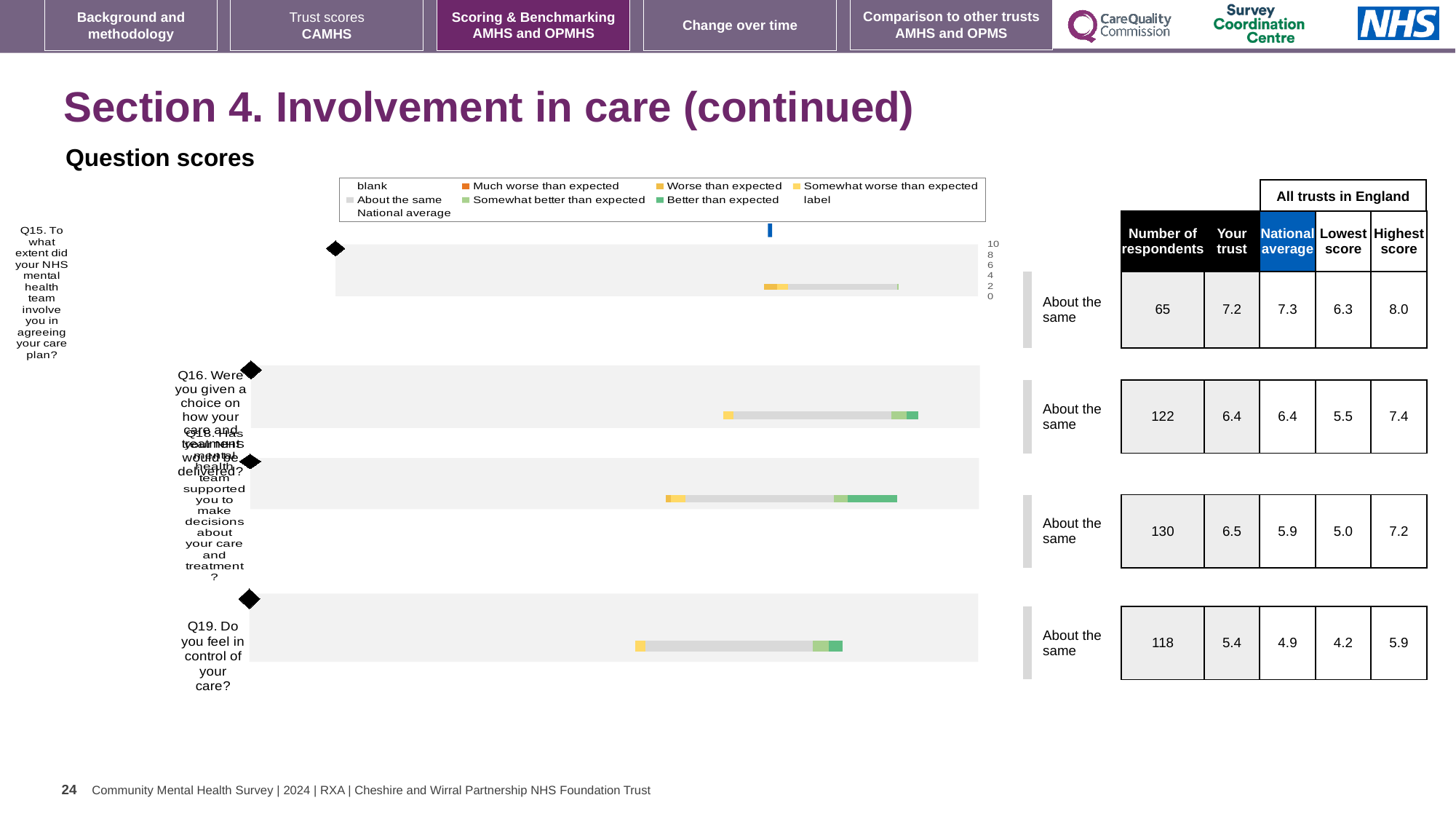
What is the number of respondents for Q15 (involvement in agreeing your care plan)? 65 What kind of chart is used to show the question scores on this slide? bar chart What is the difference between the 'Your trust' score and the national average for Q18? 0.6 For Q15, which is larger: the 'Your trust' score or the national average? National average What is the highest score among all trusts in England for Q19 (feeling in control of your care)? 5.9 What is the lowest score among all trusts in England for Q15? 6.3 How many questions are plotted in the question scores chart? 4 What is the national average score for Q18 (supported to make decisions about care and treatment)? 5.9 Which question has the lowest 'Your trust' score? Q19 Which question has the highest number of respondents? Q18 What benchmark category is shown for all four questions on this slide? About the same What is the 'Your trust' score for Q16 (choice on how care and treatment would be delivered)? 6.4